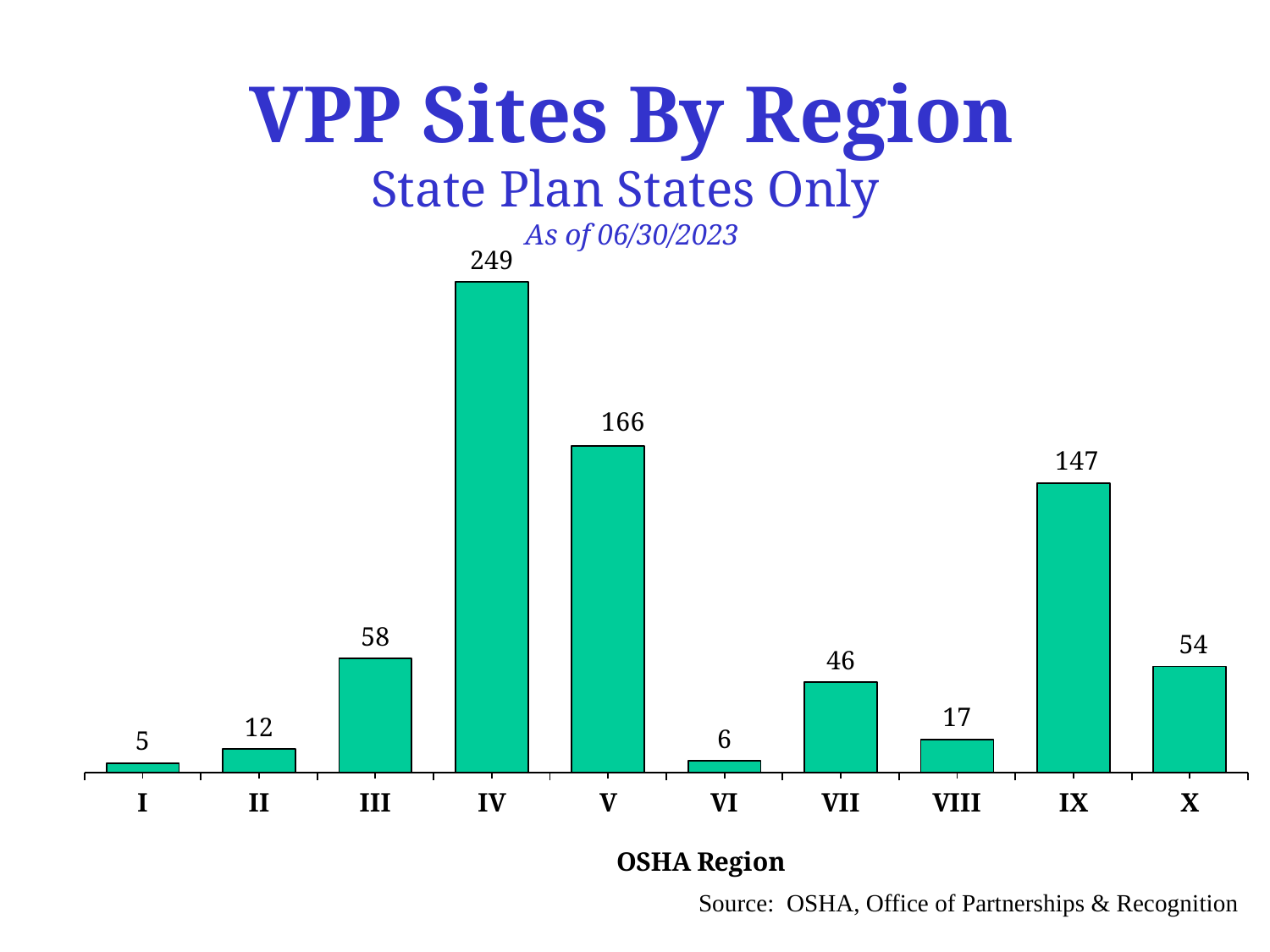
What is the x-axis title of the chart? OSHA Region What is the difference between the values for Region IV and Region V? 83 How many VPP sites does Region VIII have? 17 Which has more VPP sites, Region VII or Region X? Region X Which OSHA region has the lowest number of VPP sites? I What kind of chart is shown on the slide? Bar chart How many more VPP sites does Region III have than Region X? 4 How many VPP sites are in OSHA Region IV? 249 What is the value shown for Region IX? 147 Which OSHA region has the highest number of VPP sites? IV What date is the chart data current as of? 06/30/2023 How many OSHA regions are shown on the x axis? 10